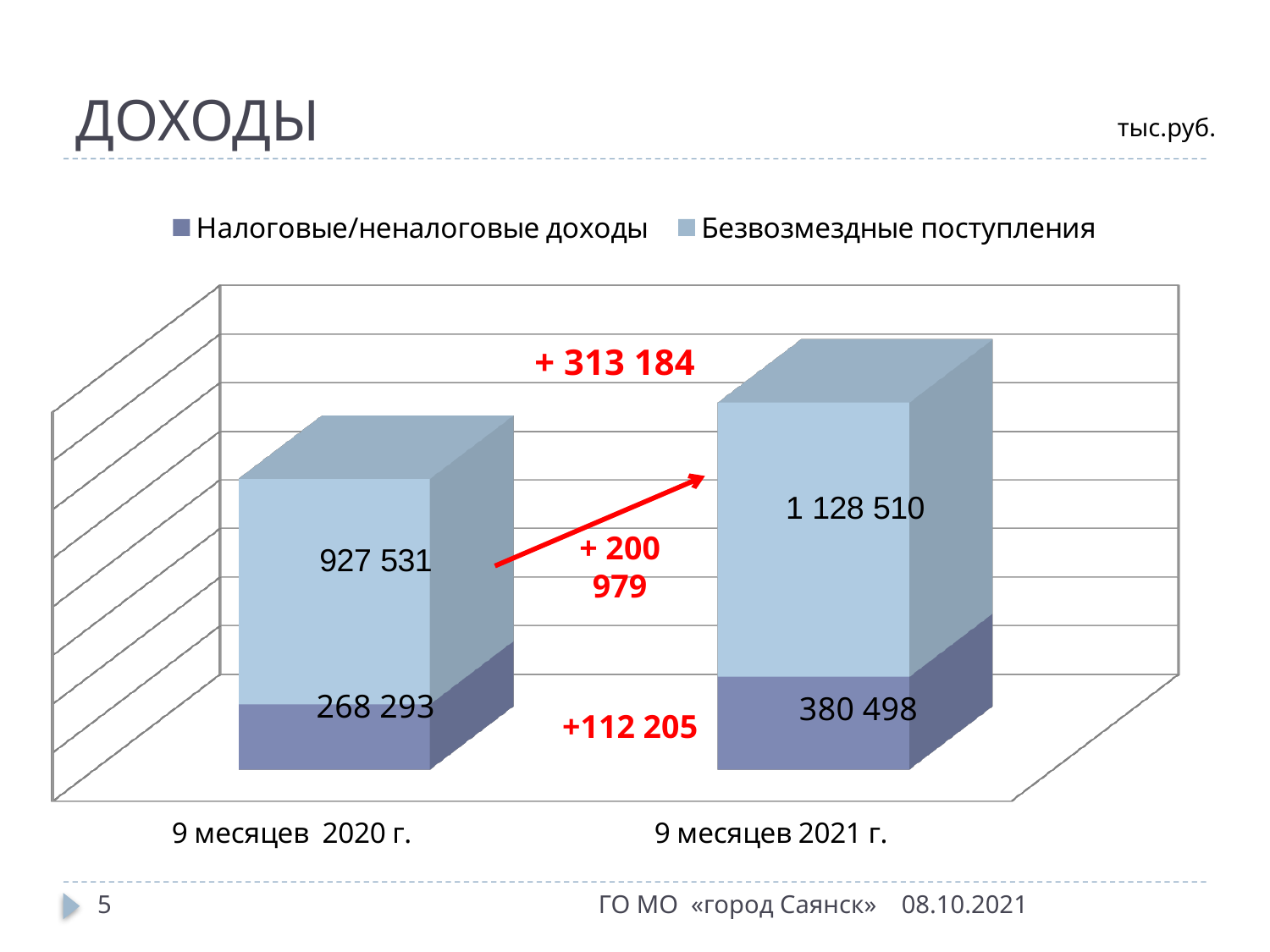
Which period has the larger value for Безвозмездные поступления, 9 месяцев 2020 г. or 9 месяцев 2021 г.? 9 месяцев 2021 г. What kind of chart is shown on the slide? Stacked bar chart What is the total of the stacked bar for 9 месяцев 2020 г.? 1 195 824 What is the value of Безвозмездные поступления for 9 месяцев 2021 г.? 1 128 510 What is the value of Налоговые/неналоговые доходы for 9 месяцев 2021 г.? 380 498 By how much did Налоговые/неналоговые доходы increase from 9 месяцев 2020 г. to 9 месяцев 2021 г.? 112 205 How many series does the legend list? 2 What is the total of the stacked bar for 9 месяцев 2021 г.? 1 509 008 By how much did Безвозмездные поступления increase from 9 месяцев 2020 г. to 9 месяцев 2021 г.? 200 979 What is the value of Безвозмездные поступления for 9 месяцев 2020 г.? 927 531 How many categories are shown on the x axis? 2 What is the value of Налоговые/неналоговые доходы for 9 месяцев 2020 г.? 268 293